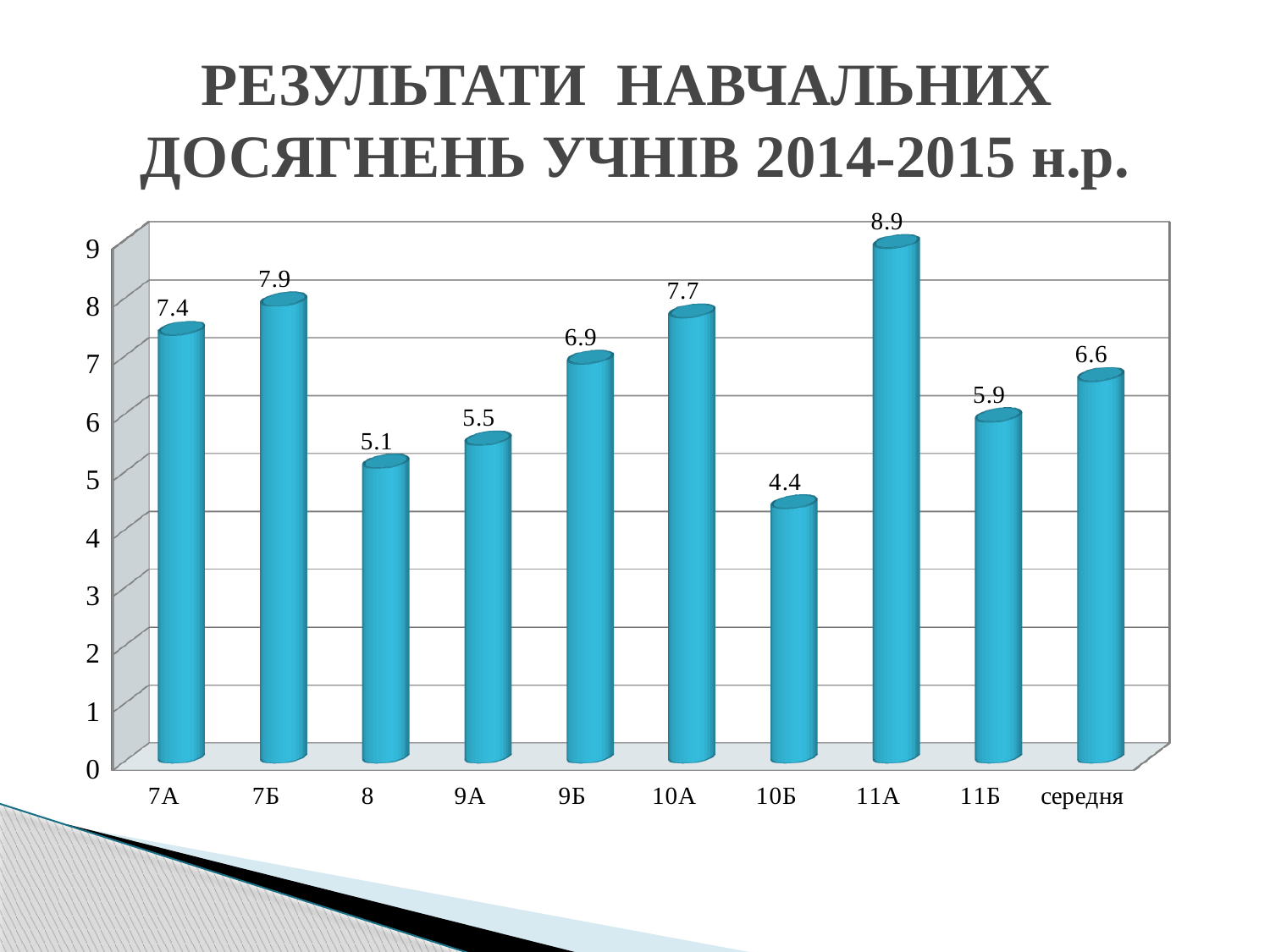
Which is larger, the value for 8 or the value for 9А? 9А What is the title of the chart on the slide? РЕЗУЛЬТАТИ НАВЧАЛЬНИХ ДОСЯГНЕНЬ УЧНІВ 2014-2015 н.р. What is the value for середня? 6.6 How many categories are shown on the x axis? 10 What is the value for 10Б? 4.4 Which category has the highest value? 11А Which category has the lowest value? 10Б What kind of chart is shown on the slide? bar chart What is the value for 7А? 7.4 What is the difference between the values for 7Б and 7А? 0.5 Which is larger, the value for 9Б or the value for 10А? 10А What is the difference between the values for 11А and 10Б? 4.5